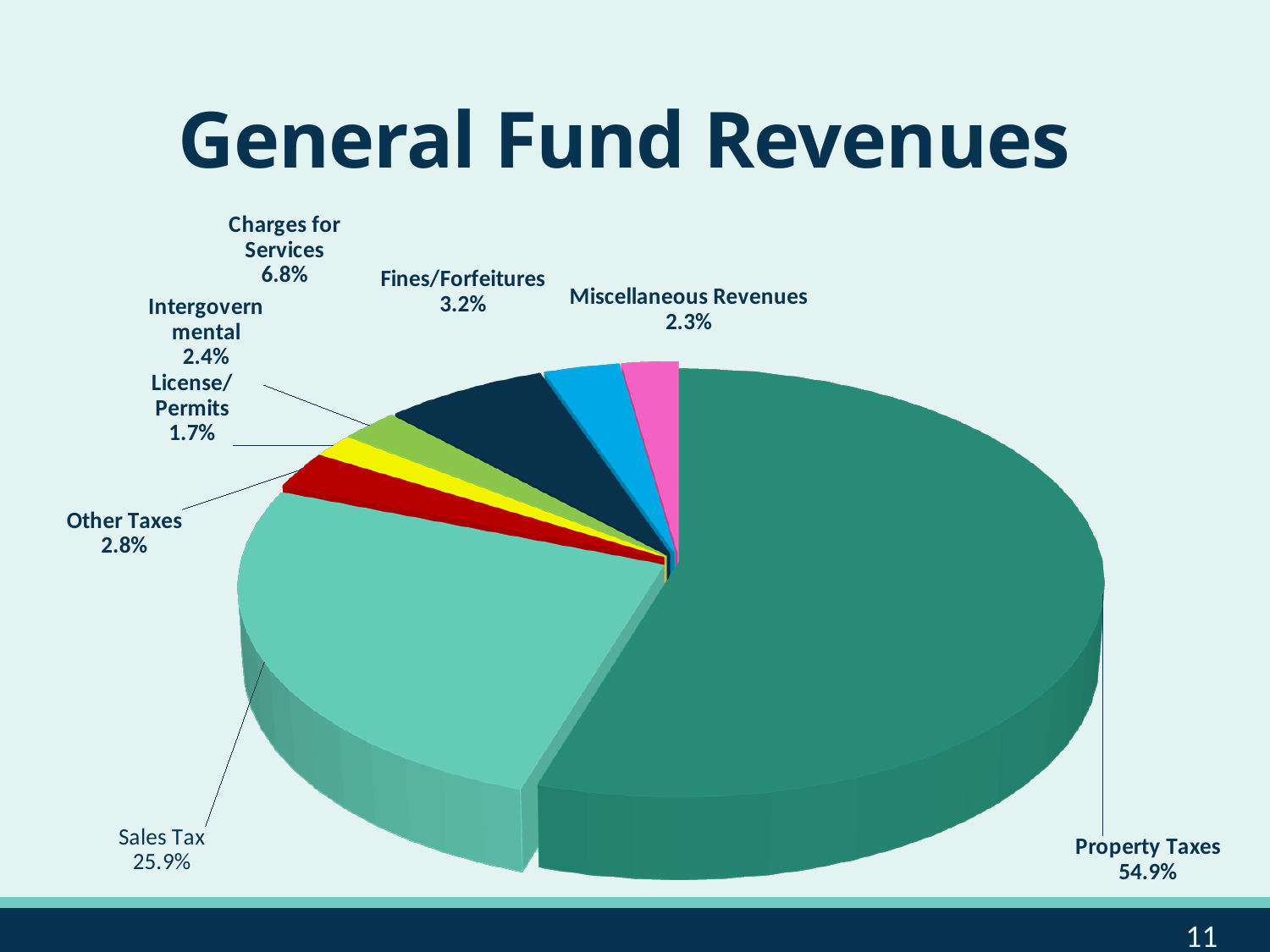
What share of General Fund Revenues comes from Property Taxes? 54.9% What percentage is shown for Charges for Services? 6.8% What percentage is shown for Fines/Forfeitures? 3.2% Which revenue category has the largest share of the pie? Property Taxes What share of General Fund Revenues comes from Sales Tax? 25.9% What kind of chart is shown on the slide? Pie chart What is the title of the chart? General Fund Revenues What percentage is shown for License/Permits? 1.7% How many revenue categories are shown in the pie chart? 8 Which revenue category has the smallest share of the pie? License/Permits Which is larger, the share for Intergovernmental or the share for Miscellaneous Revenues? Intergovernmental What is the difference in percentage points between Property Taxes and Sales Tax? 29.0 percentage points